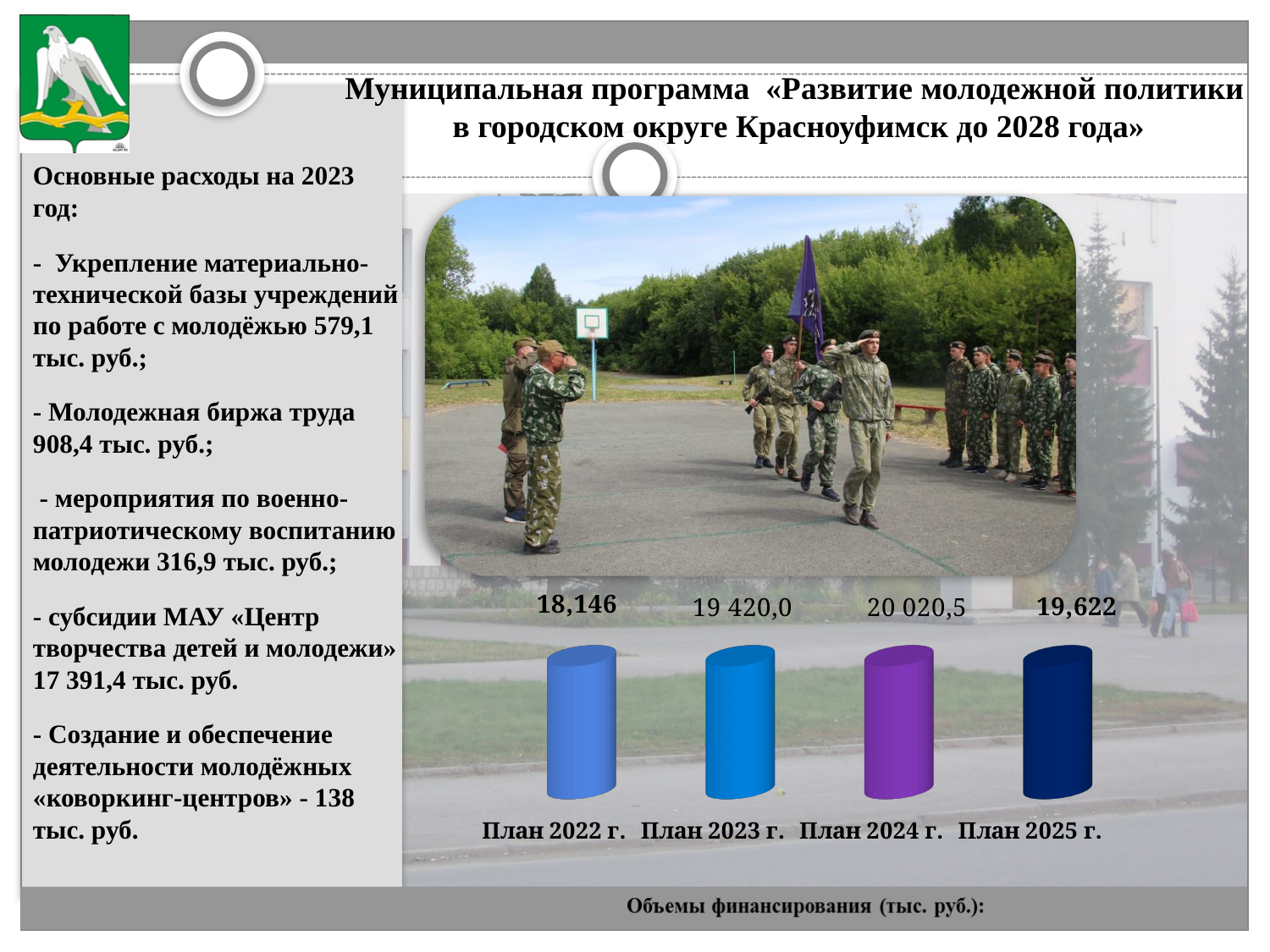
Which category has the lowest value in the chart? План 2022 г. What is the value for План 2023 г. in the chart? 19 420,0 Which is larger, the value for План 2024 г. or the value for План 2023 г.? План 2024 г. What is the value for План 2022 г. in the chart? 18,146 What is the difference between the values for План 2024 г. and План 2023 г.? 600,5 Which category has the highest value in the chart? План 2024 г. What is the value for План 2025 г. in the chart? 19,622 Do the values rise or fall from План 2022 г. to План 2024 г.? Rise What kind of chart is shown on the slide? Bar chart How many categories are shown in the chart? 4 What is the value for План 2024 г. in the chart? 20 020,5 What unit is stated in the chart caption at the bottom of the slide? тыс. руб.